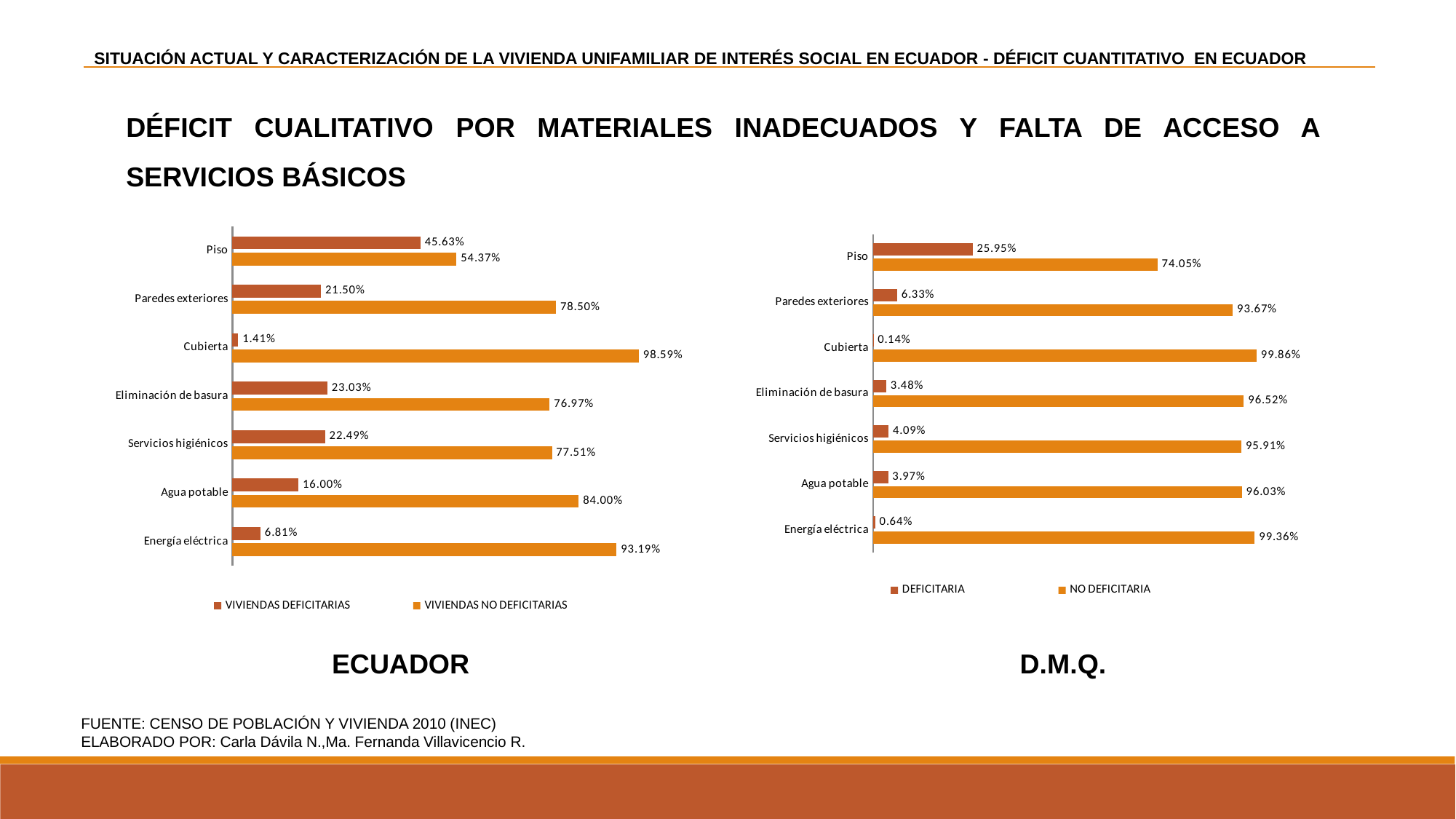
How many series does the legend of the D.M.Q. chart list? 2 In the D.M.Q. chart, which is larger: the DEFICITARIA value for Servicios higiénicos or for Agua potable? Servicios higiénicos In the ECUADOR chart, what is the value of VIVIENDAS DEFICITARIAS for Piso? 45.63% How many categories are shown in the ECUADOR chart? 7 What are the two legend entries in the ECUADOR chart? VIVIENDAS DEFICITARIAS and VIVIENDAS NO DEFICITARIAS In the ECUADOR chart, which category has the highest VIVIENDAS DEFICITARIAS value? Piso In the ECUADOR chart, what is the value of VIVIENDAS NO DEFICITARIAS for Agua potable? 84.00% In the D.M.Q. chart, what is the value of DEFICITARIA for Energía eléctrica? 0.64% In the ECUADOR chart, what is the difference between the VIVIENDAS NO DEFICITARIAS and VIVIENDAS DEFICITARIAS values for Paredes exteriores? 57.00% In the D.M.Q. chart, which category has the lowest DEFICITARIA value? Cubierta In the D.M.Q. chart, what is the value of NO DEFICITARIA for Cubierta? 99.86% What kind of chart is the ECUADOR chart? Bar chart